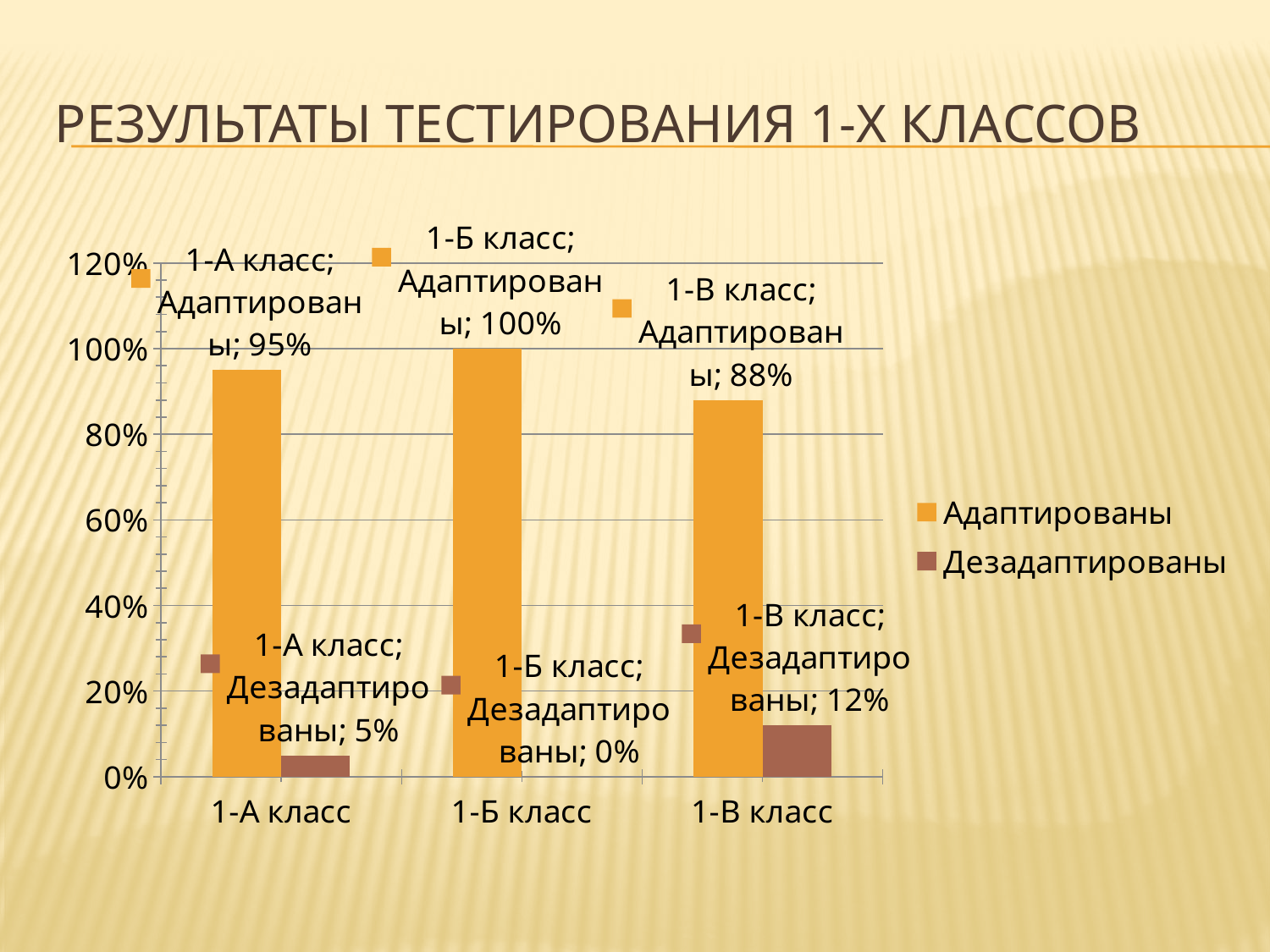
Is the value for Адаптированы in 1-В класс greater or less than 80%? greater What is the value for Адаптированы in 1-Б класс? 100% What is the value for Адаптированы in 1-А класс? 95% Which class has the highest value for Адаптированы? 1-Б класс Which is larger: the Дезадаптированы value for 1-А класс or for 1-В класс? 1-В класс How many series does the legend list? 2 What kind of chart is shown on the slide? bar chart Which class has the lowest value for Дезадаптированы? 1-Б класс What is the difference between the Адаптированы values for 1-Б класс and 1-В класс? 12% What is the value for Дезадаптированы in 1-Б класс? 0% What is the value for Дезадаптированы in 1-В класс? 12% How many classes are shown on the x axis? 3